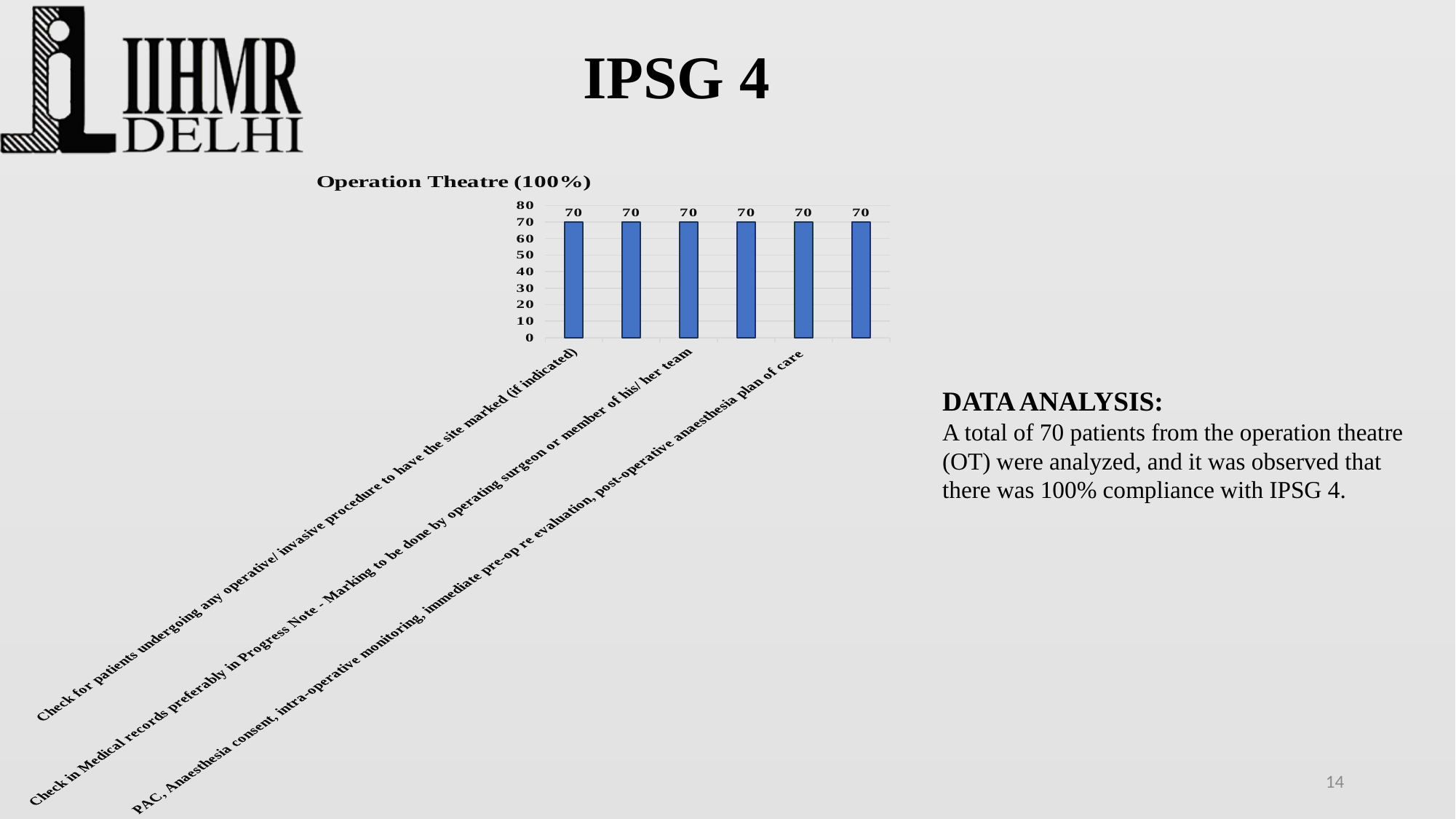
Is the value for the last bar greater or less than 80? less What is the difference between the value of the first bar and the value of the last bar? 0 How many bars are plotted in the chart? 6 What is the highest value shown on the vertical axis? 80 What is the value for 'Check for patients undergoing any operative/ invasive procedure to have the site marked (if indicated)'? 70 What type of chart is shown on the slide? bar chart Is the value for the first bar greater or less than 50? greater What is the title of the chart? Operation Theatre (100%) What value is shown on the data label of the first bar? 70 What is the value for 'PAC, Anaesthesia consent, intra-operative monitoring, immediate pre-op re evaluation, post-operative anaesthesia plan of care'? 70 What is the value shown on the data label of the last bar? 70 Do the bar values rise, fall, or stay the same across the chart? stay the same